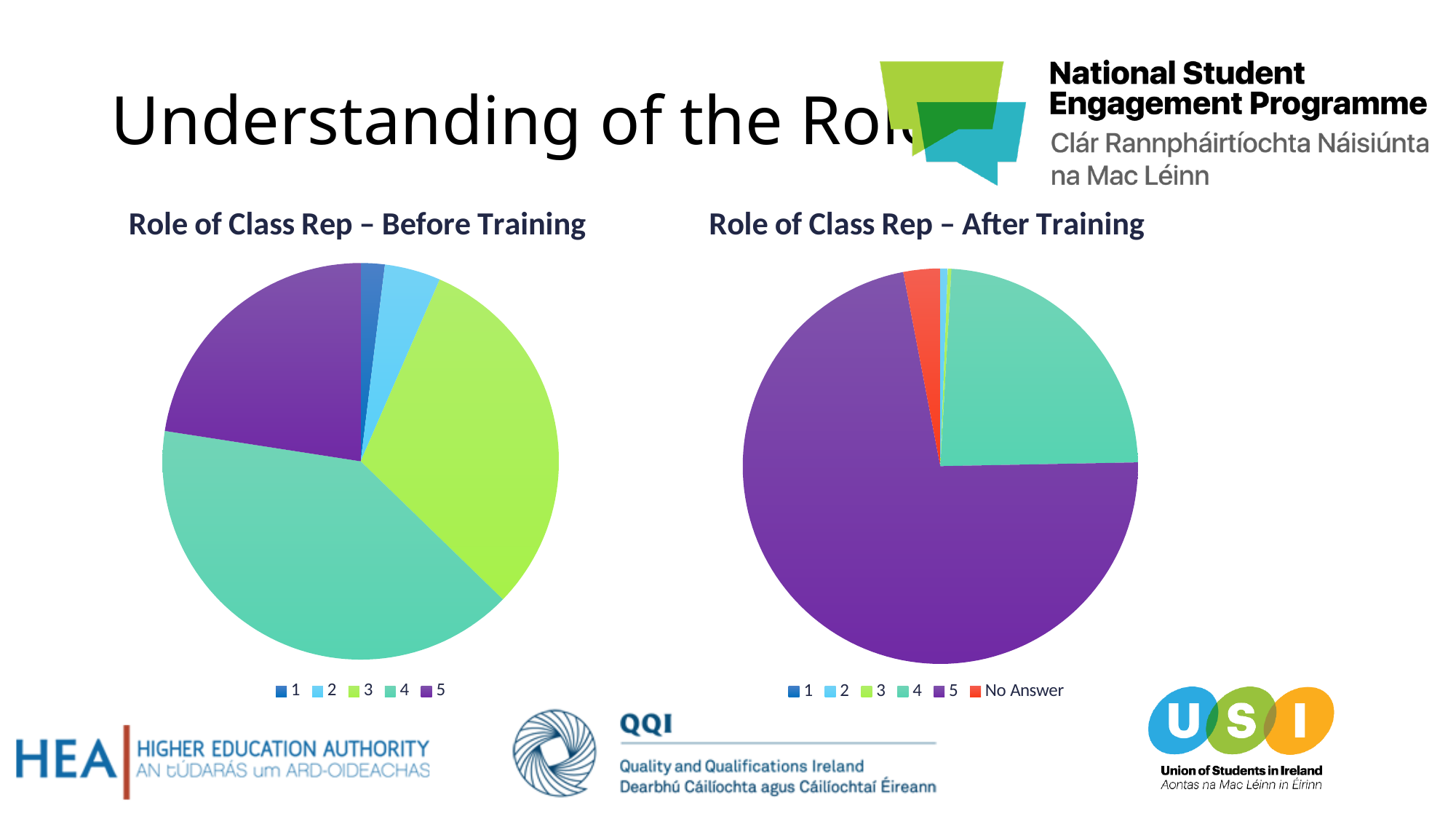
In the 'Role of Class Rep – After Training' chart, which legend entry is shown in red? No Answer In the 'Role of Class Rep – Before Training' chart, which slice is larger, 2 or 1? 2 What kind of chart is the 'Role of Class Rep – Before Training' chart? pie chart In the 'Role of Class Rep – After Training' chart, which slice is larger, 5 or 4? 5 In the 'Role of Class Rep – After Training' chart, which slice is larger, 4 or No Answer? 4 How many entries does the legend of the 'Role of Class Rep – Before Training' chart list? 5 How many entries does the legend of the 'Role of Class Rep – After Training' chart list? 6 In the 'Role of Class Rep – Before Training' chart, which category has the largest slice? 4 In the 'Role of Class Rep – After Training' chart, which category has the largest slice? 5 In the 'Role of Class Rep – Before Training' chart, which category has the smallest slice? 1 What kind of chart is the 'Role of Class Rep – After Training' chart? pie chart